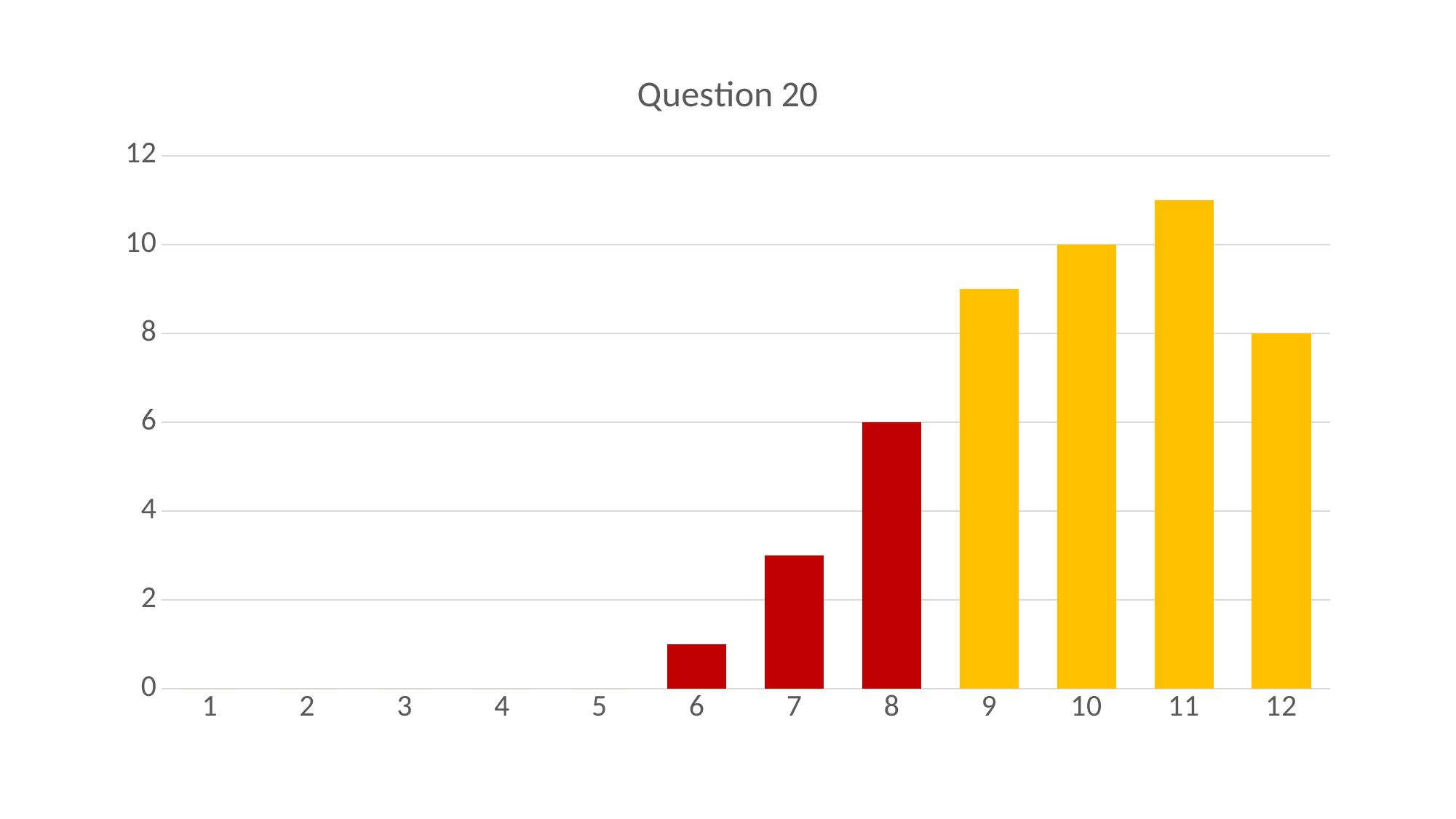
Is the value for category 9 greater or less than 8? greater What is the difference between the values for category 10 and category 12? 2 Which is larger, the value for category 8 or the value for category 11? 11 What is the value for category 3? 0 What is the value for category 8? 6 What is the value for category 10? 10 What is the value for category 12? 8 Is the value for category 7 greater or less than 4? less What kind of chart is shown on the slide? bar chart What is the title of the chart? Question 20 How many categories are shown on the x axis? 12 Which category has the highest bar? 11